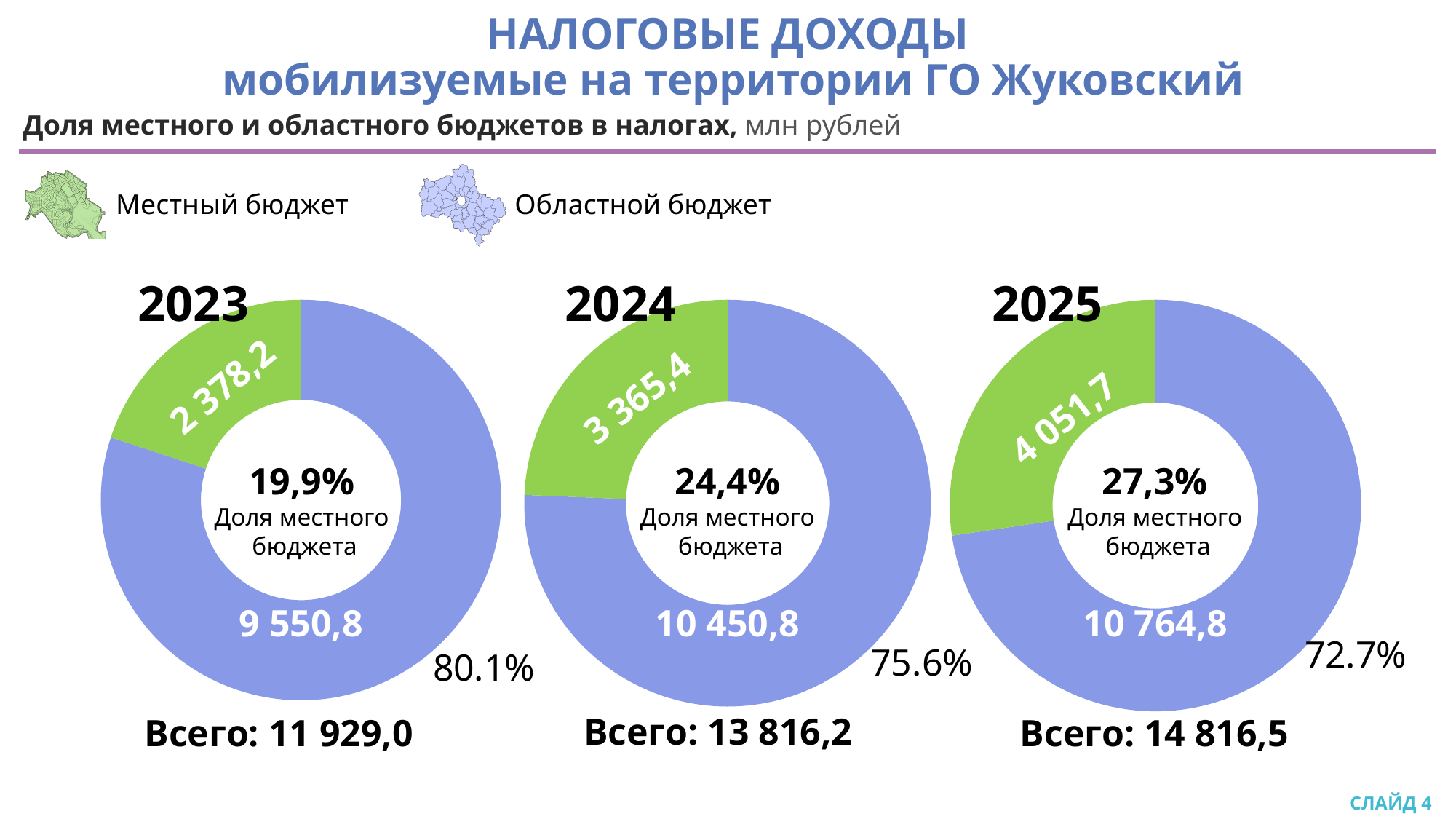
Across the three charts, in which year is the total (Всего) the lowest? 2023 In the 2025 chart, what is the difference between the regional budget and the local budget values? 6 713,1 In the 2025 chart, what is the value for the local budget (Местный бюджет)? 4 051,7 Across the three charts, in which year is the local budget value the highest? 2025 In the 2025 chart, what share of the total does the local budget (Доля местного бюджета) have? 27,3% What is the total (Всего) shown for the 2024 chart? 13 816,2 In the 2024 chart, what is the value for the regional budget (Областной бюджет)? 10 450,8 In the 2023 chart, what is the value for the local budget (Местный бюджет)? 2 378,2 What kind of chart is used for each year on this slide? Donut (pie) chart In the 2024 chart, which is larger: the local budget or the regional budget? Областной бюджет In the 2023 chart, what share of the total does the regional budget have? 80.1% How many budget categories does the legend list? 2